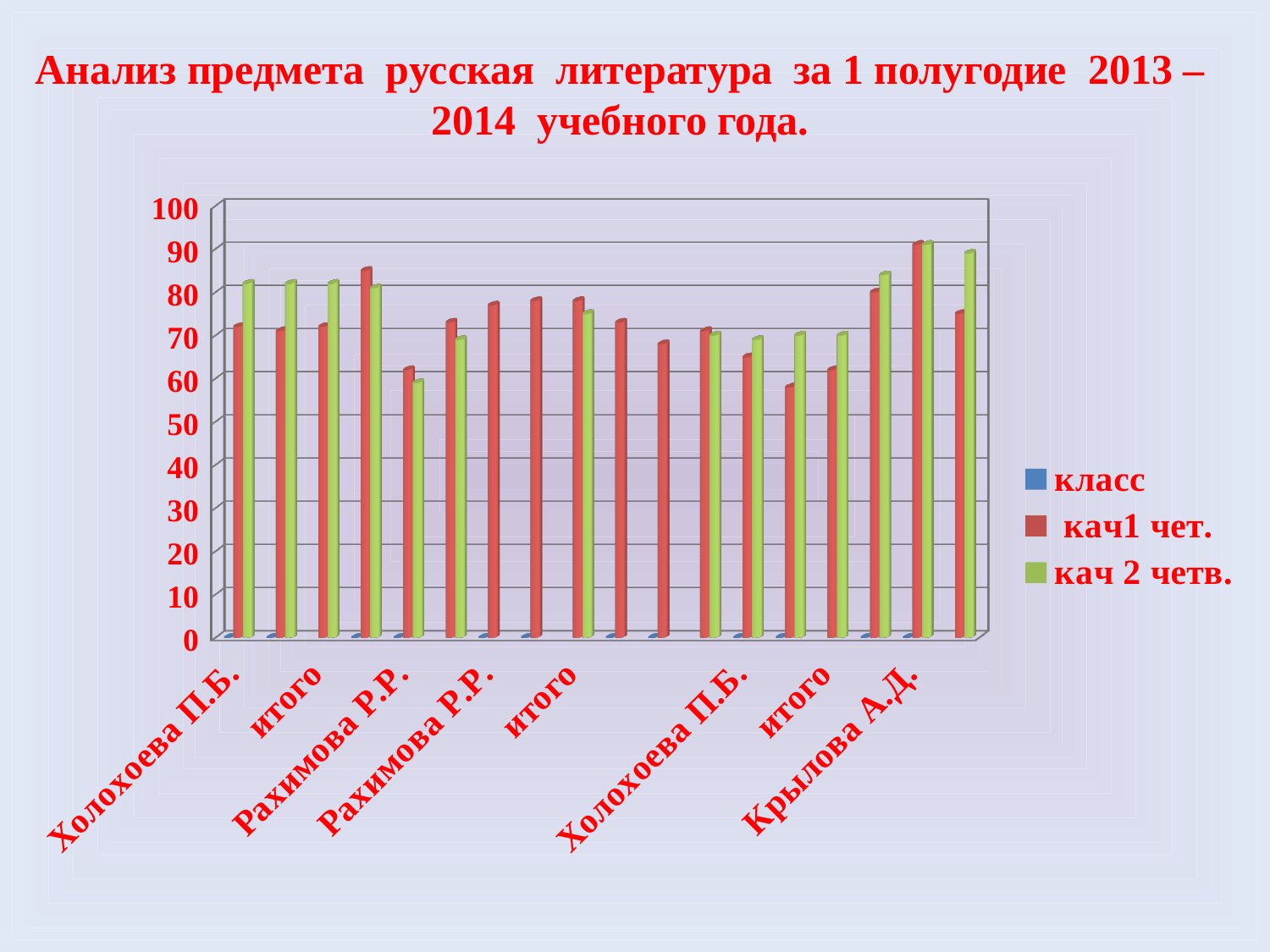
What is the title of the slide above the chart? Анализ предмета русская литература за 1 полугодие 2013 – 2014 учебного года. How many series does the legend list? 3 What kind of chart is shown on the slide? bar chart Is the tallest red (кач1 чет.) bar greater or less than 80? greater Is the кач1 чет. value for the first category, Холохоева П.Б., greater or less than 80? less Is the shortest red (кач1 чет.) bar greater or less than 70? less Which series has the smallest bars throughout the chart? класс How many groups of bars are plotted along the x axis? 18 What are the three series named in the legend? класс, кач1 чет., кач 2 четв. What is the highest value shown on the vertical axis? 100